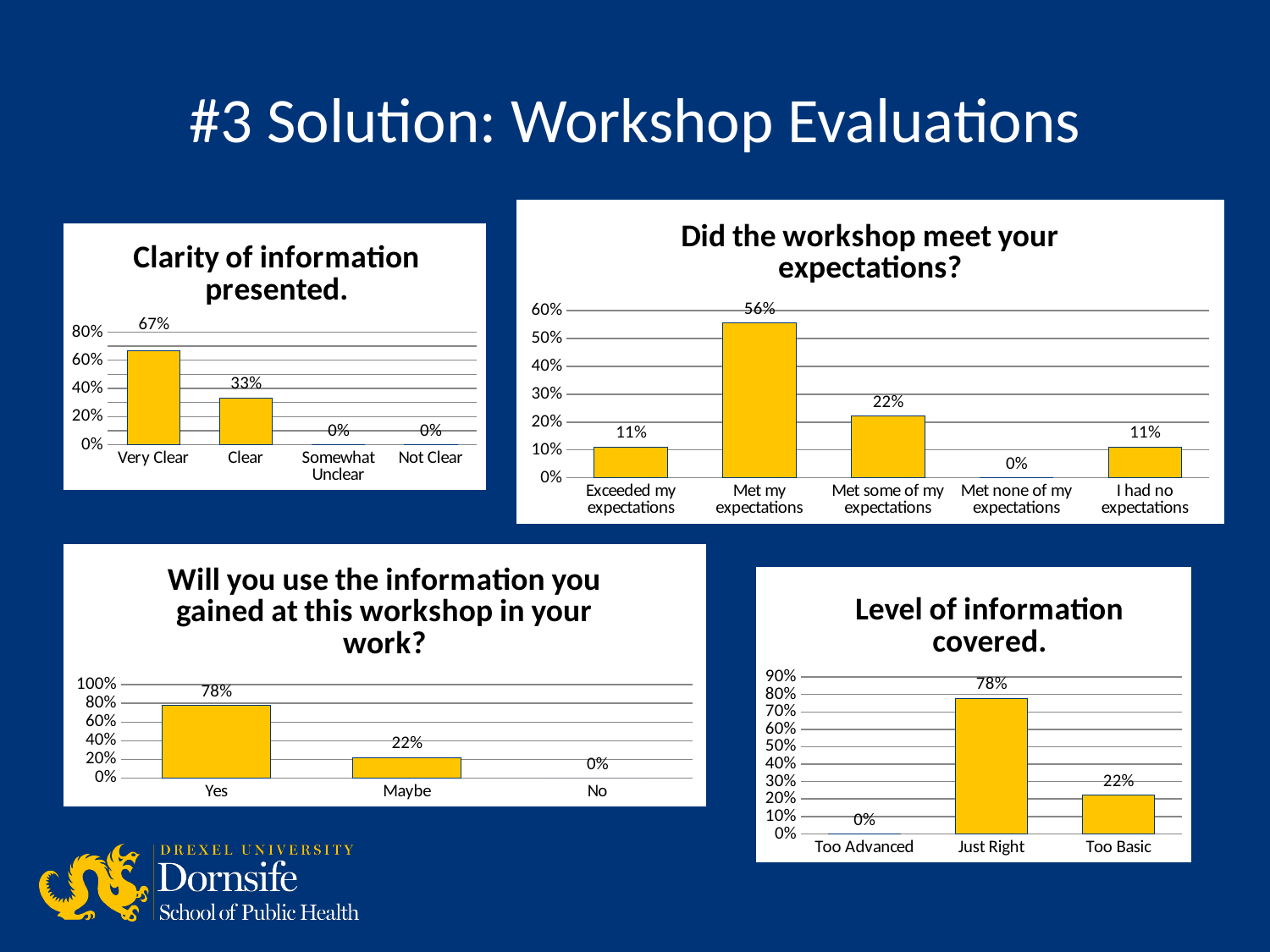
In the 'Did the workshop meet your expectations?' chart, what is the value for Met my expectations? 56% In the 'Will you use the information you gained at this workshop in your work?' chart, what is the value for Yes? 78% What type of chart is the 'Level of information covered.' chart? Bar chart In the 'Level of information covered.' chart, which category has the lowest value? Too Advanced In the 'Level of information covered.' chart, what is the value for Too Basic? 22% In the 'Clarity of information presented.' chart, what is the value for Very Clear? 67% In the 'Did the workshop meet your expectations?' chart, how many categories are shown on the x axis? 5 In the 'Did the workshop meet your expectations?' chart, which is larger, Met some of my expectations or Exceeded my expectations? Met some of my expectations In the 'Did the workshop meet your expectations?' chart, what is the value for Met none of my expectations? 0% In the 'Will you use the information you gained at this workshop in your work?' chart, what is the difference between Yes and Maybe? 56% In the 'Clarity of information presented.' chart, which category has the highest value? Very Clear In the 'Clarity of information presented.' chart, what is the difference between Very Clear and Clear? 34%